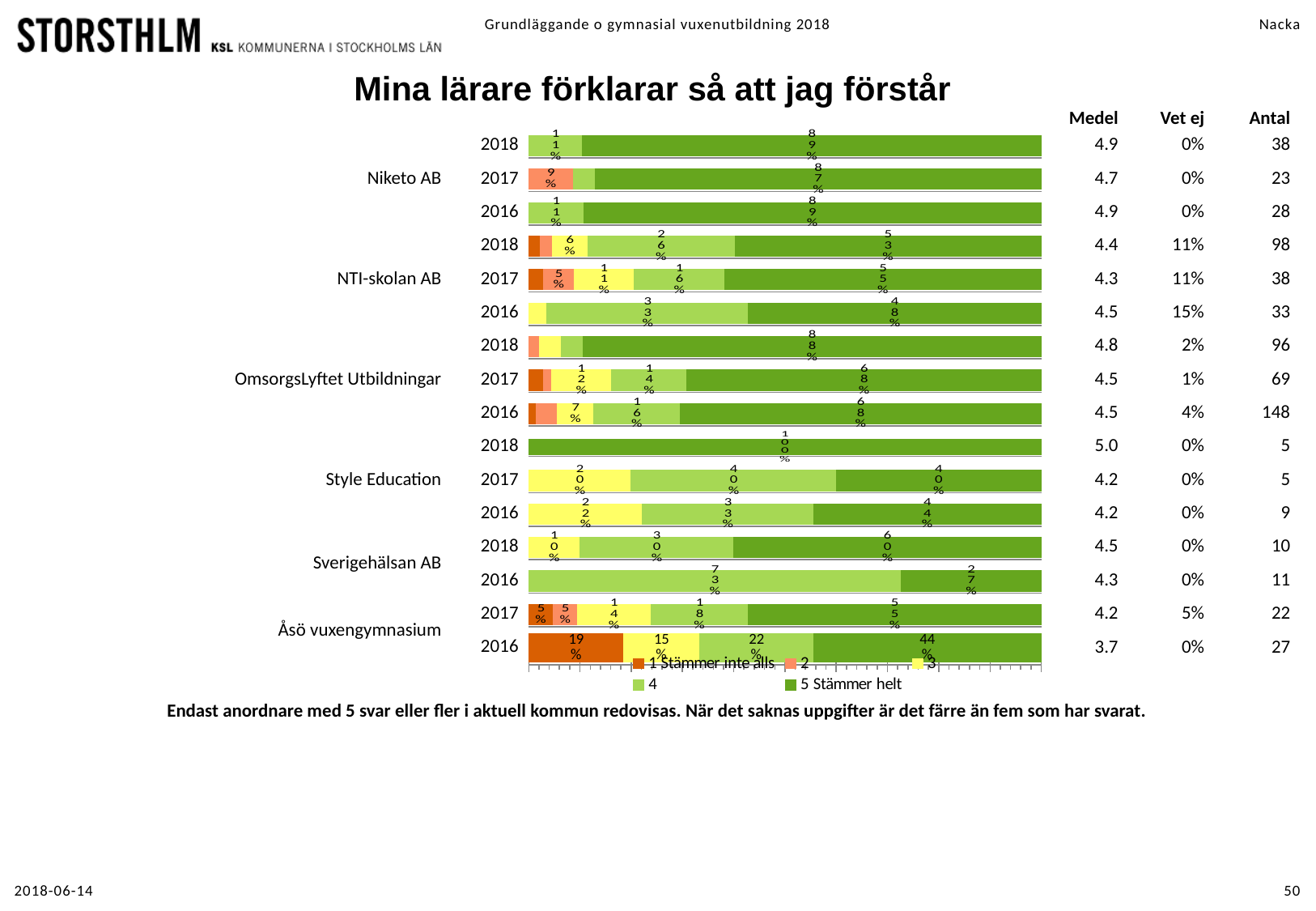
What is the '1 Stämmer inte alls' value for Åsö vuxengymnasium in 2016? 19% Which response category has the largest share in the Åsö vuxengymnasium 2016 bar? 5 Stämmer helt What share of the Style Education 2018 bar is '5 Stämmer helt'? 100% For Åsö vuxengymnasium 2016, what is the difference between the '5 Stämmer helt' value and the '1 Stämmer inte alls' value? 25 percentage points What is the '5 Stämmer helt' value for NTI-skolan AB in 2018? 53% What kind of chart is shown on the slide? bar chart For Style Education 2017, which is larger: the value for series '4' or for series '3'? 4 How many bars are plotted in the chart? 16 What is the title of the chart? Mina lärare förklarar så att jag förstår How many series does the chart legend list? 5 What is the '5 Stämmer helt' value for Niketo AB in 2018? 89% What is the value of series '4' for Sverigehälsan AB in 2016? 73%